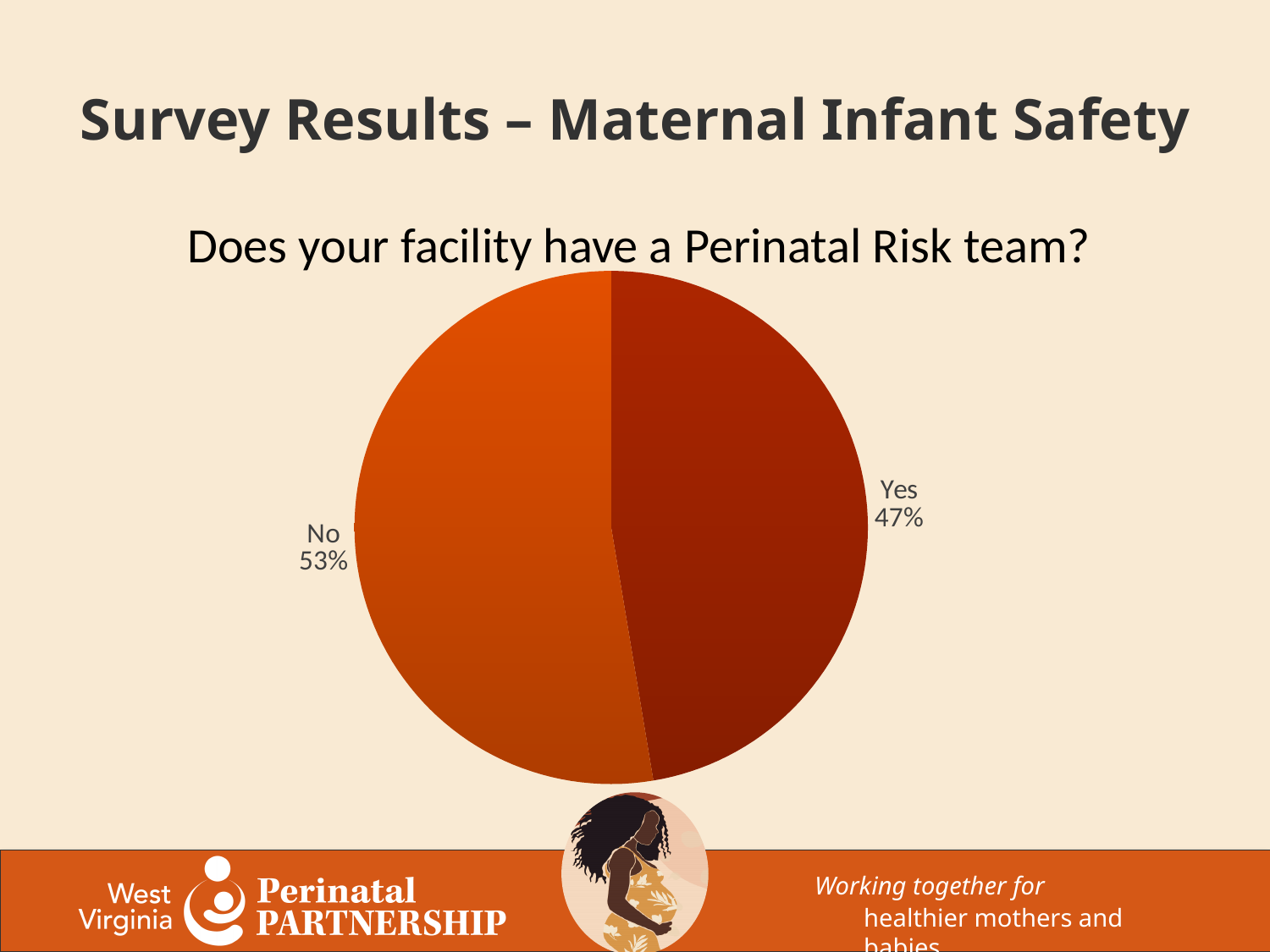
What question does the pie chart's title ask? Does your facility have a Perinatal Risk team? What type of chart is shown on the slide? Pie chart Is the share for No greater or less than 50%? greater What is the title of the slide? Survey Results – Maternal Infant Safety Which response has the larger share of the pie, Yes or No? No What is the difference in percentage points between the No and Yes responses? 6 percentage points Which response has the smallest share of the pie? Yes What share of the pie does the Yes slice represent? 47% How many slices does the pie chart have? 2 What percentage of respondents answered "No" to whether their facility has a Perinatal Risk team? 53% What percentage of respondents answered "Yes" to whether their facility has a Perinatal Risk team? 47%